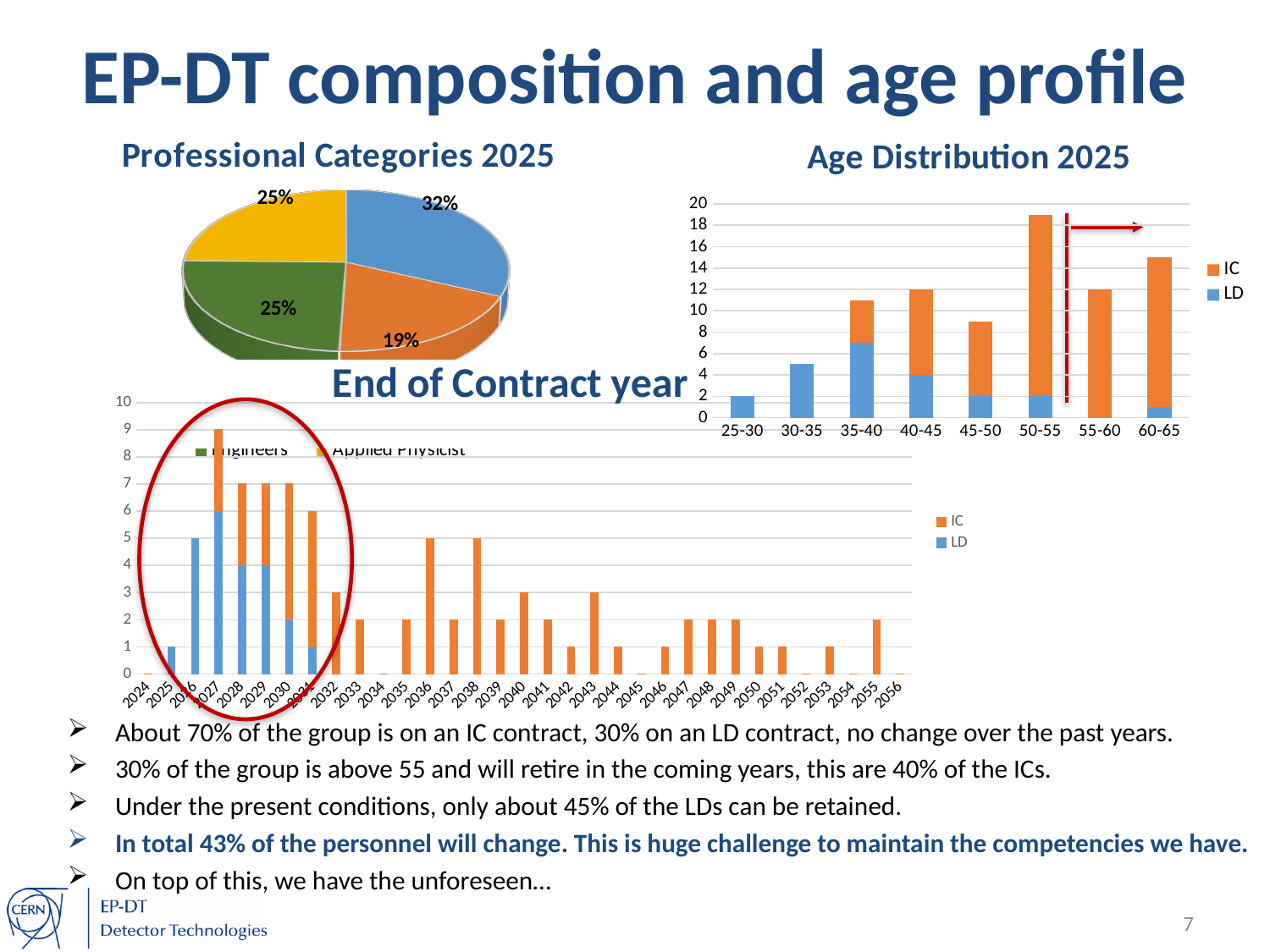
In the Professional Categories 2025 pie chart, what is the percentage of the smallest slice? 19% In the Age Distribution 2025 chart, how many age groups are shown on the x axis? 8 In the Professional Categories 2025 pie chart, what is the percentage of the largest slice? 32% What kind of chart is the Professional Categories 2025 chart? Pie chart In the End of Contract year chart, which year has the tallest bar? 2027 In the Age Distribution 2025 chart, which age group has the tallest bar? 50-55 How many slices does the Professional Categories 2025 pie chart have? 4 How many series does the legend of the Age Distribution 2025 chart list? 2 In the Age Distribution 2025 chart, which age group has the shortest bar? 25-30 In the End of Contract year chart, what is the total value for 2036? 5 In the Age Distribution 2025 chart, is the total value for 50-55 greater or less than 16? greater What kind of chart is the End of Contract year chart? Bar chart